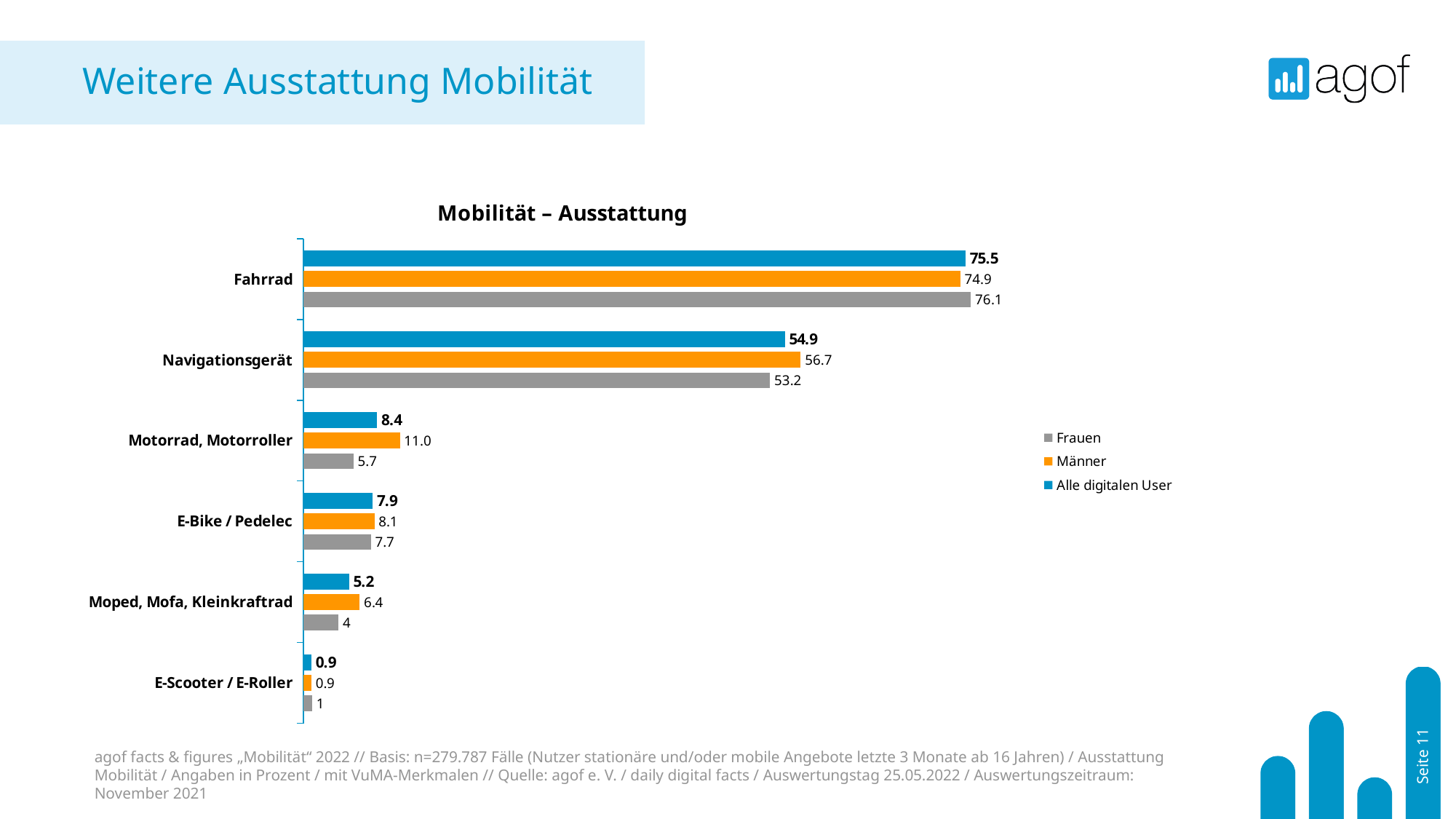
What is the difference between the Männer and Frauen values for Motorrad, Motorroller? 5.3 What is the value for E-Scooter / E-Roller in the Frauen series? 1 Which category has the highest value in the Alle digitalen User series? Fahrrad What is the value for Motorrad, Motorroller in the Frauen series? 5.7 What is the title of the chart? Mobilität – Ausstattung What is the value for Navigationsgerät in the Männer series? 56.7 Which category has the lowest value in the Männer series? E-Scooter / E-Roller What is the value for Fahrrad in the Alle digitalen User series? 75.5 How many series does the legend list? 3 Which is larger for Navigationsgerät: the Männer value or the Frauen value? Männer How many categories are shown on the chart? 6 What kind of chart is shown on the slide? Bar chart